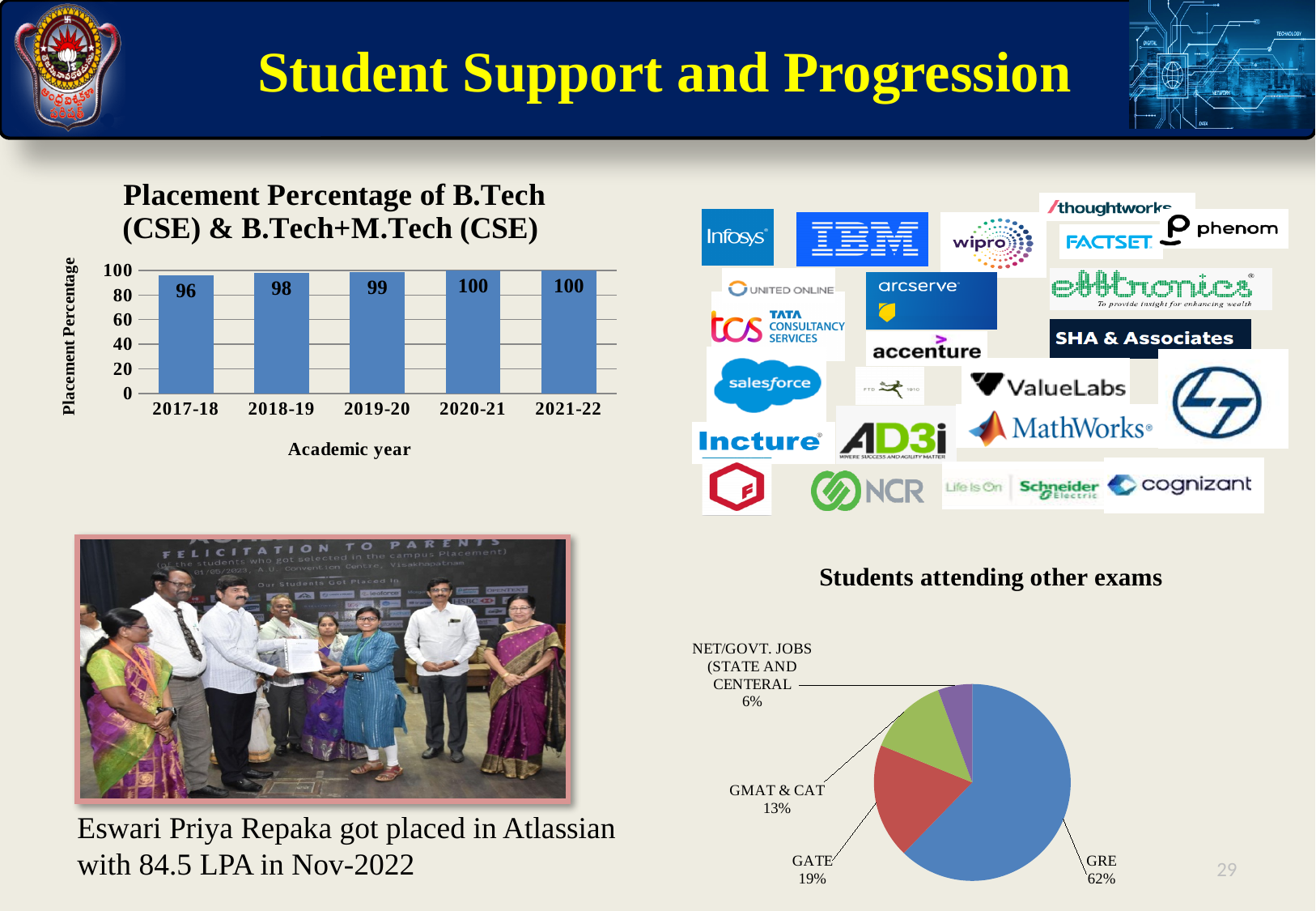
In the 'Placement Percentage' bar chart, what is the difference between the placement percentage for 2021-22 and 2017-18? 4 In the 'Students attending other exams' pie chart, what share of students attend GATE? 19% In the 'Students attending other exams' pie chart, which exam has the largest share? GRE What kind of chart is the 'Placement Percentage of B.Tech (CSE) & B.Tech+M.Tech (CSE)' chart? bar chart In the 'Placement Percentage' bar chart, what is the placement percentage for 2019-20? 99 In the 'Placement Percentage' bar chart, what is the label of the x axis? Academic year In the 'Students attending other exams' pie chart, which is larger, the share for GMAT & CAT or the share for NET/GOVT. JOBS? GMAT & CAT In the 'Placement Percentage' bar chart, what is the placement percentage for 2017-18? 96 In the 'Students attending other exams' pie chart, how many slices are there? 4 In the 'Placement Percentage' bar chart, which academic year has the lowest placement percentage? 2017-18 In the 'Placement Percentage' bar chart, how many academic years are shown on the x axis? 5 In the 'Placement Percentage' bar chart, do the values rise or fall from 2017-18 to 2021-22? rise